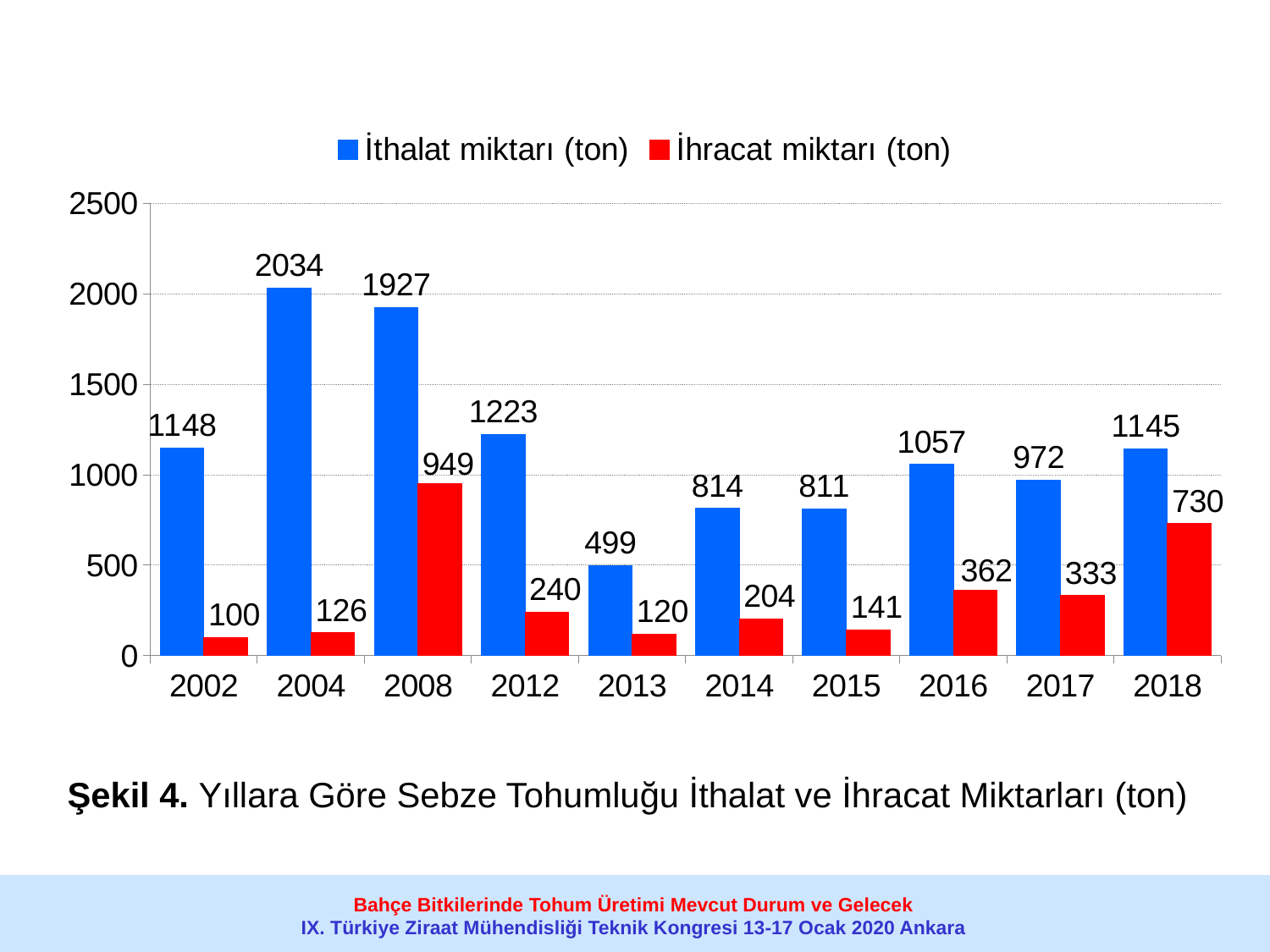
How many years are shown on the x axis? 10 What colour are the İhracat miktarı (ton) bars? red Is the İthalat miktarı (ton) value for 2013 greater or less than 500? less Which year has the lowest İhracat miktarı (ton)? 2002 What kind of chart is shown on the slide? bar chart Which is larger, the İhracat miktarı (ton) for 2016 or for 2017? 2016 How many series does the legend list? 2 What is the difference between the İthalat miktarı (ton) and İhracat miktarı (ton) values for 2008? 978 What is the İthalat miktarı (ton) value for 2004? 2034 Which year has the highest İthalat miktarı (ton)? 2004 Does the İhracat miktarı (ton) rise or fall from 2015 to 2018? rise What is the İhracat miktarı (ton) value for 2018? 730